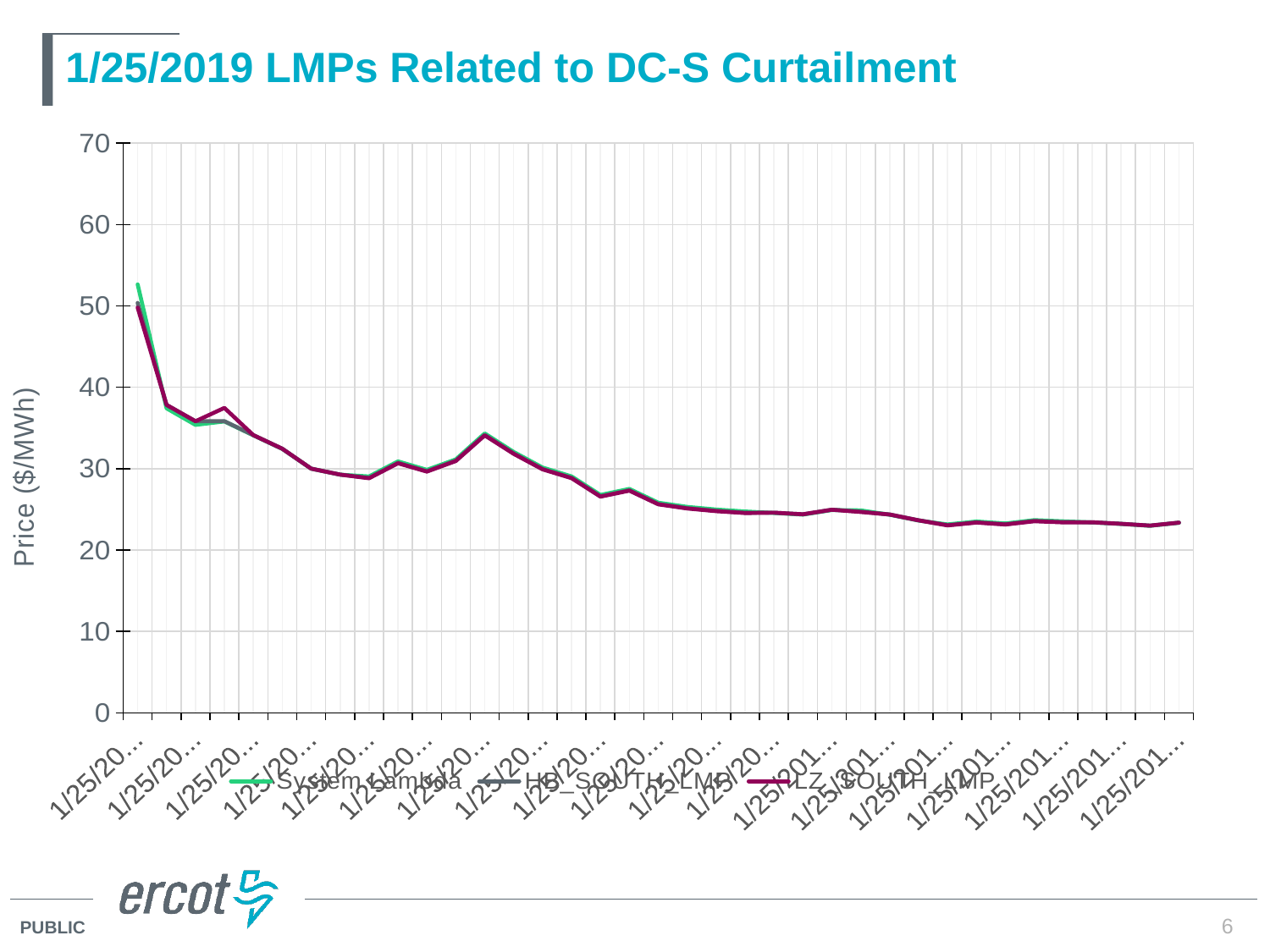
Is the highest value of the System Lambda series greater or less than 40? greater What is the title of the chart? 1/25/2019 LMPs Related to DC-S Curtailment What is the label on the vertical axis? Price ($/MWh) Do the plotted prices generally rise or fall from left to right along the x axis? fall Is the final value of the LZ_SOUTH_LMP series greater or less than 30? less What kind of chart is shown on the slide? line chart Is the highest value of the HB_SOUTH_LMP series greater or less than 60? less How many series does the legend list? 3